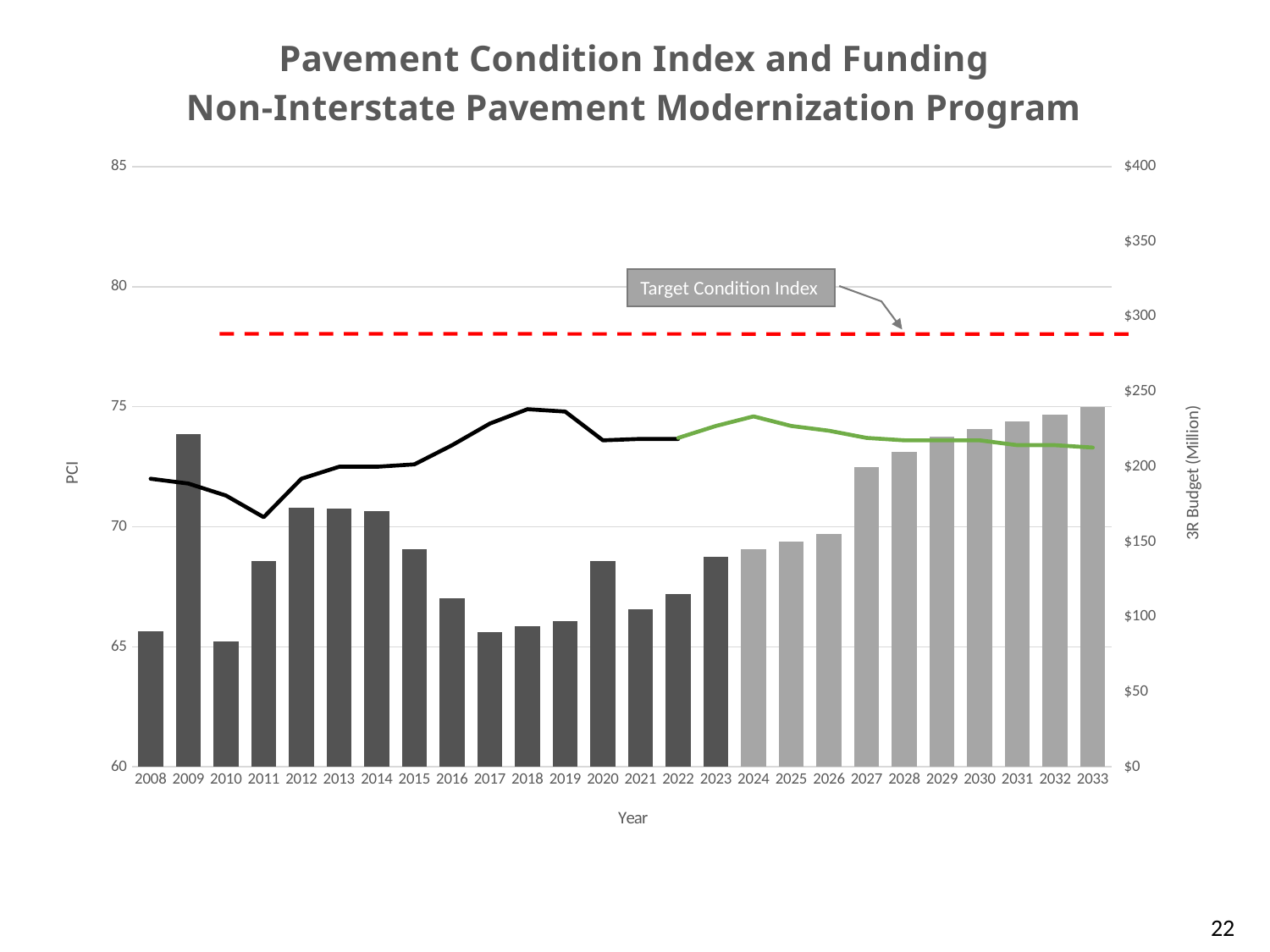
Is the 3R Budget for 2009 greater or less than $200 million? greater What kind of chart is shown on the slide? A combination bar and line chart What does the red dashed line represent? Target Condition Index Is the 3R Budget for 2010 greater or less than $100 million? less In which year is the PCI line at its lowest? 2011 Is the Target Condition Index greater or less than 75? greater Does the PCI line rise or fall from 2008 to 2011? fall Among the years 2008 to 2023, which year has the highest 3R Budget bar? 2009 How many years are shown along the x axis? 26 What is the title of the chart? Pavement Condition Index and Funding Non-Interstate Pavement Modernization Program Do the 3R Budget bars rise or fall from 2024 to 2033? rise